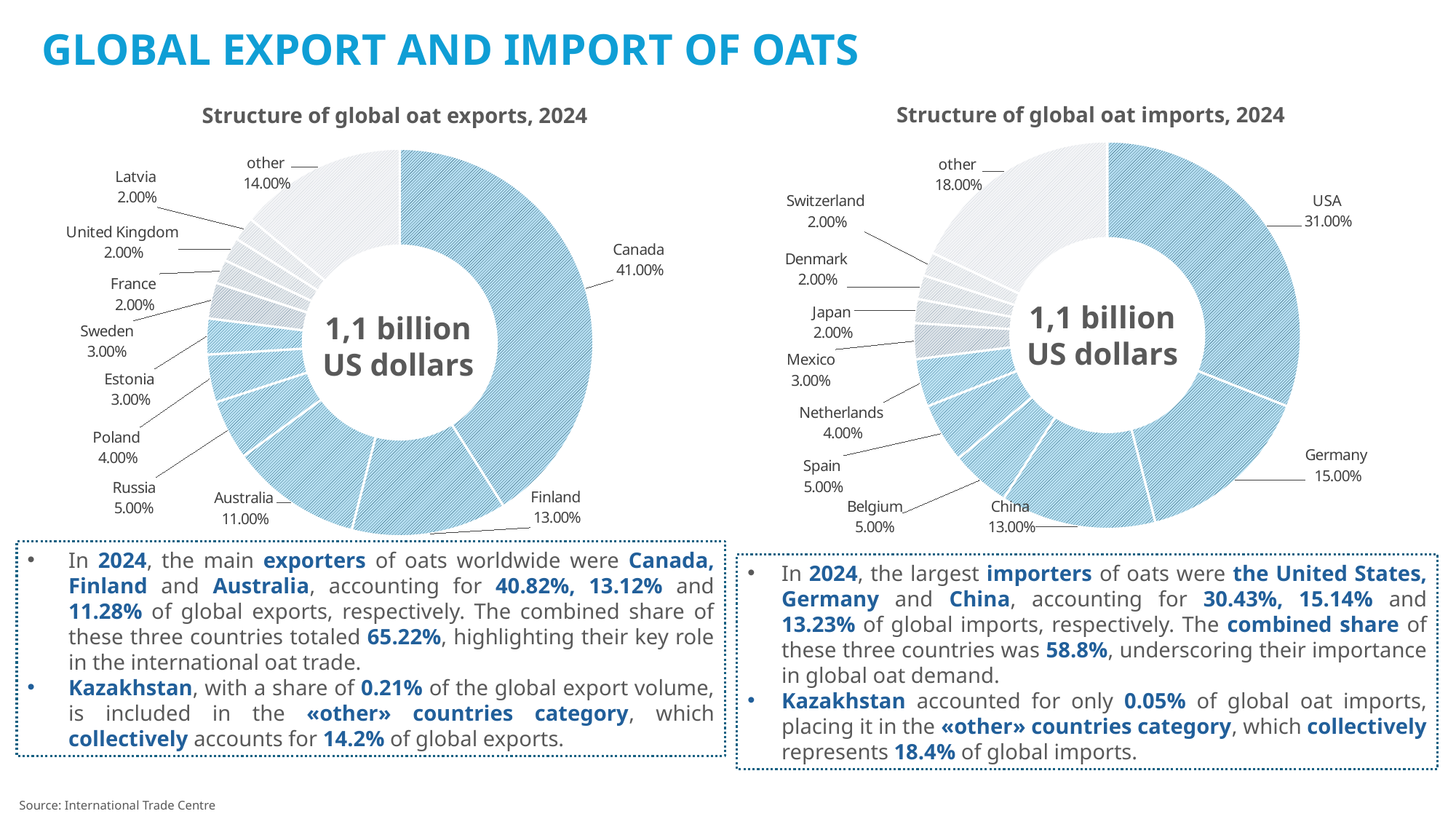
In the 'Structure of global oat exports, 2024' chart, which country has the largest share? Canada How many slices does the 'Structure of global oat exports, 2024' chart have? 11 In the 'Structure of global oat imports, 2024' chart, which country has the largest share? USA In the 'Structure of global oat imports, 2024' chart, what is the difference between the shares of USA and China? 18.00% In the 'Structure of global oat exports, 2024' chart, what share does Canada have? 41.00% What type of chart is the 'Structure of global oat imports, 2024' chart? Donut (pie) chart In the 'Structure of global oat exports, 2024' chart, what is the difference between the shares of Canada and Finland? 28.00% In the 'Structure of global oat exports, 2024' chart, which is larger: the share of Australia or the share of Finland? Finland In the 'Structure of global oat imports, 2024' chart, which is larger: the share of Netherlands or the share of Mexico? Netherlands What text is shown in the centre of the 'Structure of global oat exports, 2024' chart? 1,1 billion US dollars In the 'Structure of global oat imports, 2024' chart, what share does Germany have? 15.00% How many slices does the 'Structure of global oat imports, 2024' chart have? 11